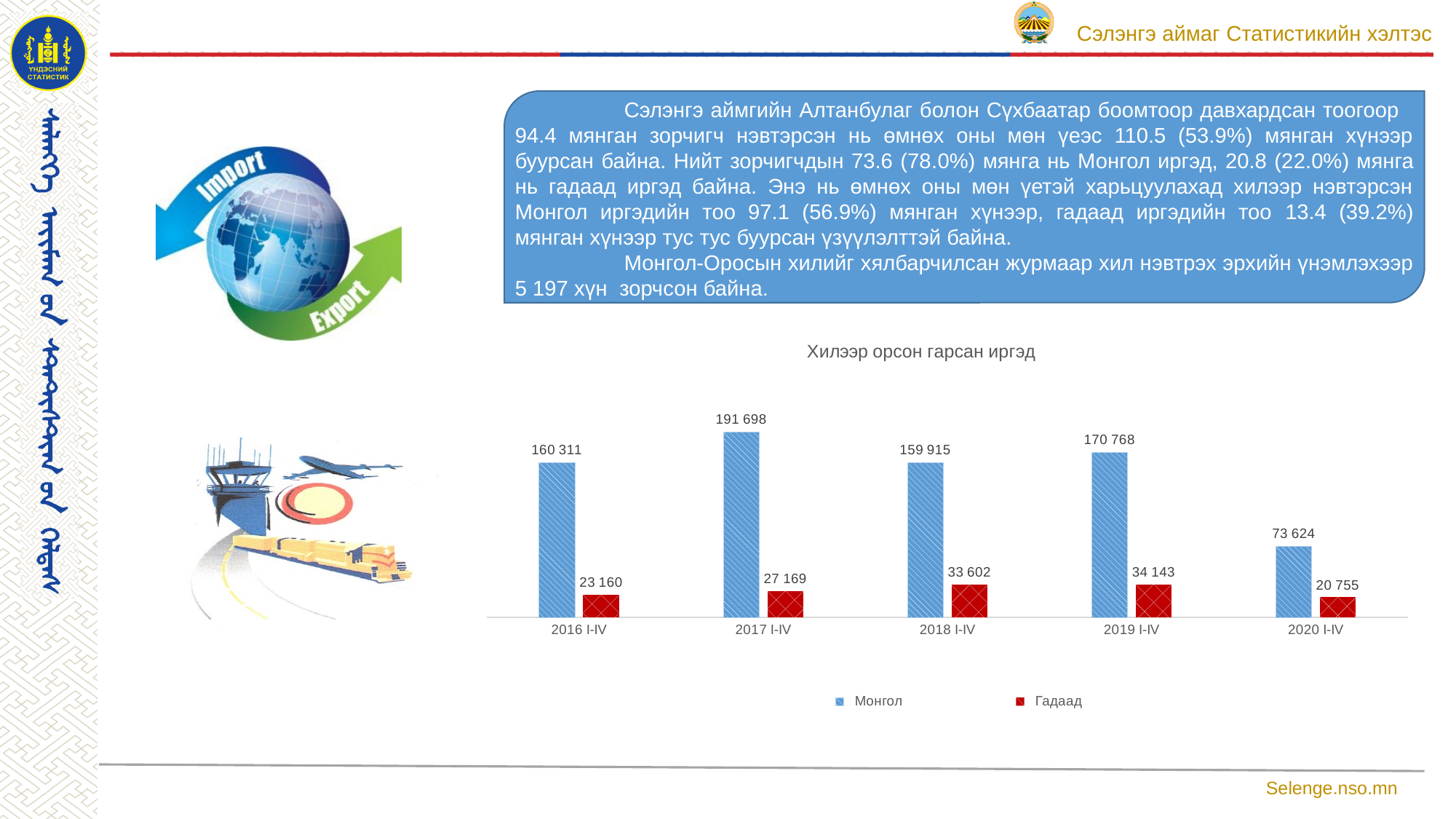
What is the difference between the Монгол values for 2019 I-IV and 2020 I-IV? 97 144 How many periods are shown on the x axis? 5 What is the title of the chart? Хилээр орсон гарсан иргэд What is the value for Монгол in 2020 I-IV? 73 624 What kind of chart is shown? Bar chart How many series does the legend list? 2 In which period is the Гадаад value lowest? 2020 I-IV What is the value for Гадаад in 2019 I-IV? 34 143 What is the value for Гадаад in 2016 I-IV? 23 160 What is the value for Монгол in 2017 I-IV? 191 698 Which is larger: the Гадаад value for 2018 I-IV or for 2017 I-IV? 2018 I-IV In which period is the Монгол value highest? 2017 I-IV